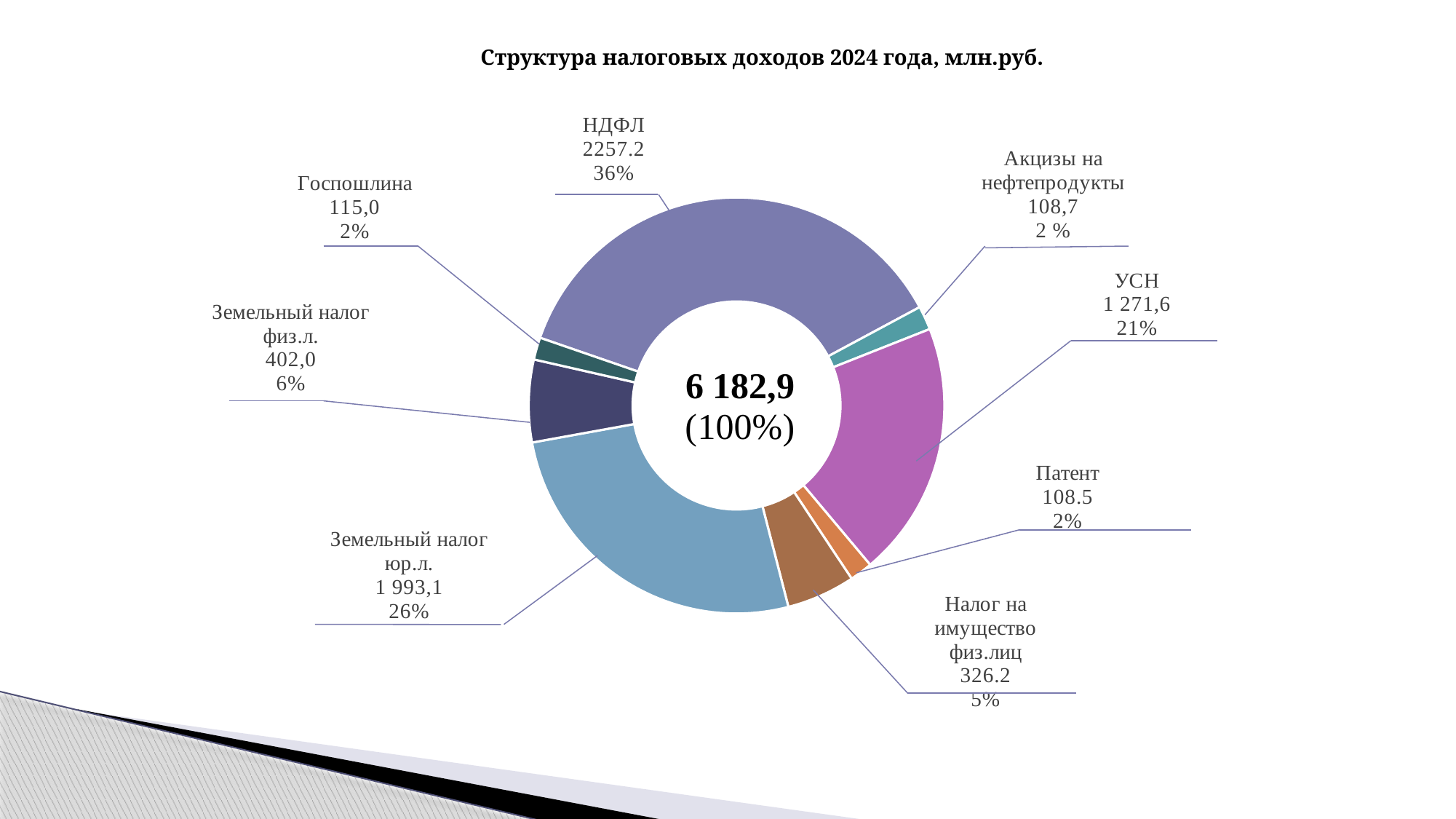
What is the title of the chart? Структура налоговых доходов 2024 года, млн.руб. What is the value for Земельный налог юр.л.? 1 993,1 Which is larger, УСН or Земельный налог юр.л.? Земельный налог юр.л. How many categories are shown in the chart? 8 What share of the total does Земельный налог физ.л. represent? 6% Which category has the largest value? НДФЛ What is the total shown in the centre of the chart? 6 182,9 What is the value for УСН? 1 271,6 What share of the total does Налог на имущество физ.лиц represent? 5% What is the value for НДФЛ? 2257.2 What is the difference between the values for Земельный налог физ.л. and Госпошлина? 287,0 What type of chart is shown on the slide? Pie (donut) chart